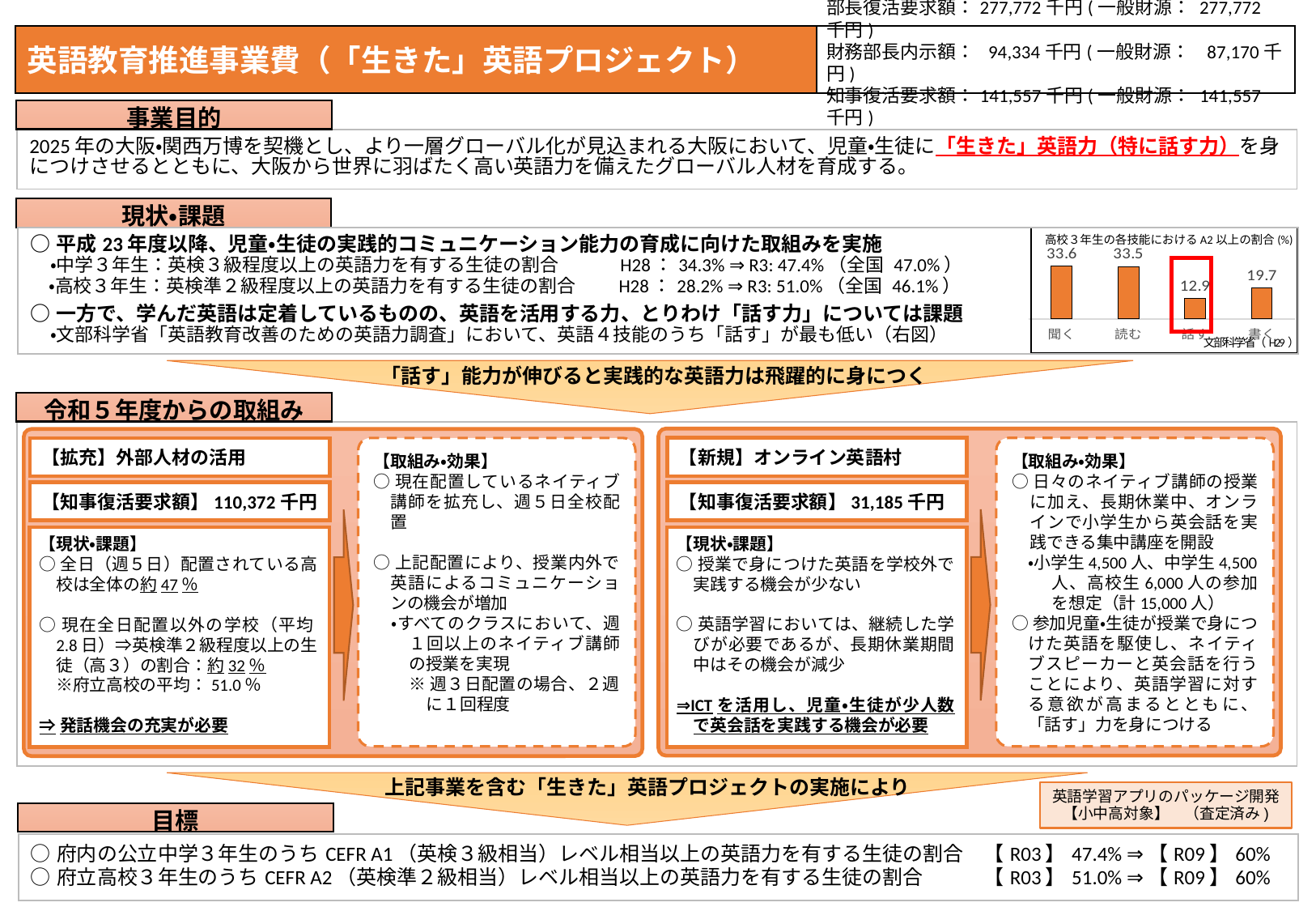
In the bar chart titled 高校３年生の各技能におけるA2以上の割合(%), what is the value for 話す? 12.9 In the bar chart titled 高校３年生の各技能におけるA2以上の割合(%), what is the value for 聞く? 33.6 What source is cited below the bar chart titled 高校３年生の各技能におけるA2以上の割合(%)? 文部科学省（H29） In the bar chart titled 高校３年生の各技能におけるA2以上の割合(%), which skill has the lowest value? 話す How many skill categories are shown in the bar chart titled 高校３年生の各技能におけるA2以上の割合(%)? 4 In the bar chart titled 高校３年生の各技能におけるA2以上の割合(%), what is the difference between the values for 書く and 話す? 6.8 In the bar chart titled 高校３年生の各技能におけるA2以上の割合(%), what is the value for 読む? 33.5 In the bar chart titled 高校３年生の各技能におけるA2以上の割合(%), which is larger, the value for 書く or the value for 話す? 書く In the bar chart titled 高校３年生の各技能におけるA2以上の割合(%), what is the value for 書く? 19.7 In the bar chart titled 高校３年生の各技能におけるA2以上の割合(%), what is the difference between the values for 聞く and 話す? 20.7 In the bar chart titled 高校３年生の各技能におけるA2以上の割合(%), which is larger, the value for 聞く or the value for 書く? 聞く What kind of chart is shown in the top right of the slide under the title 高校３年生の各技能におけるA2以上の割合(%)? Bar chart